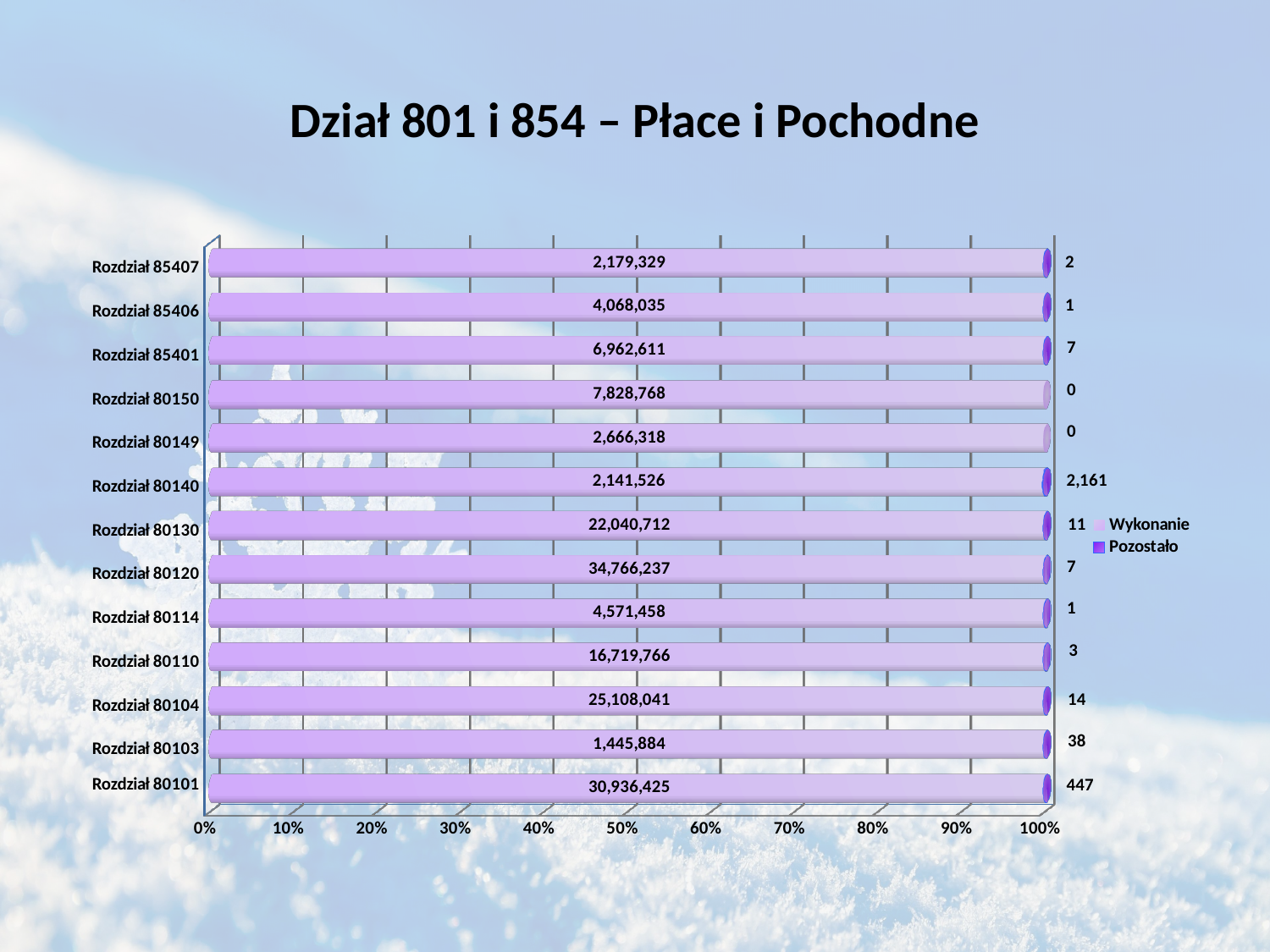
Which category has the highest Wykonanie value? Rozdział 80120 What is the Wykonanie value for Rozdział 80101? 30,936,425 What is the Pozostało value for Rozdział 80103? 38 What is the difference between the Wykonanie values for Rozdział 80120 and Rozdział 80101? 3,829,812 Which category has the highest Pozostało value? Rozdział 80140 Which has the larger Wykonanie value, Rozdział 80130 or Rozdział 80104? Rozdział 80104 How many categories (Rozdział entries) are shown on the chart? 13 What is the Pozostało value for Rozdział 80140? 2,161 How many series does the legend list? 2 Which category has the lowest Wykonanie value? Rozdział 80103 What kind of chart is shown on the slide? Bar chart What is the Wykonanie value for Rozdział 85401? 6,962,611